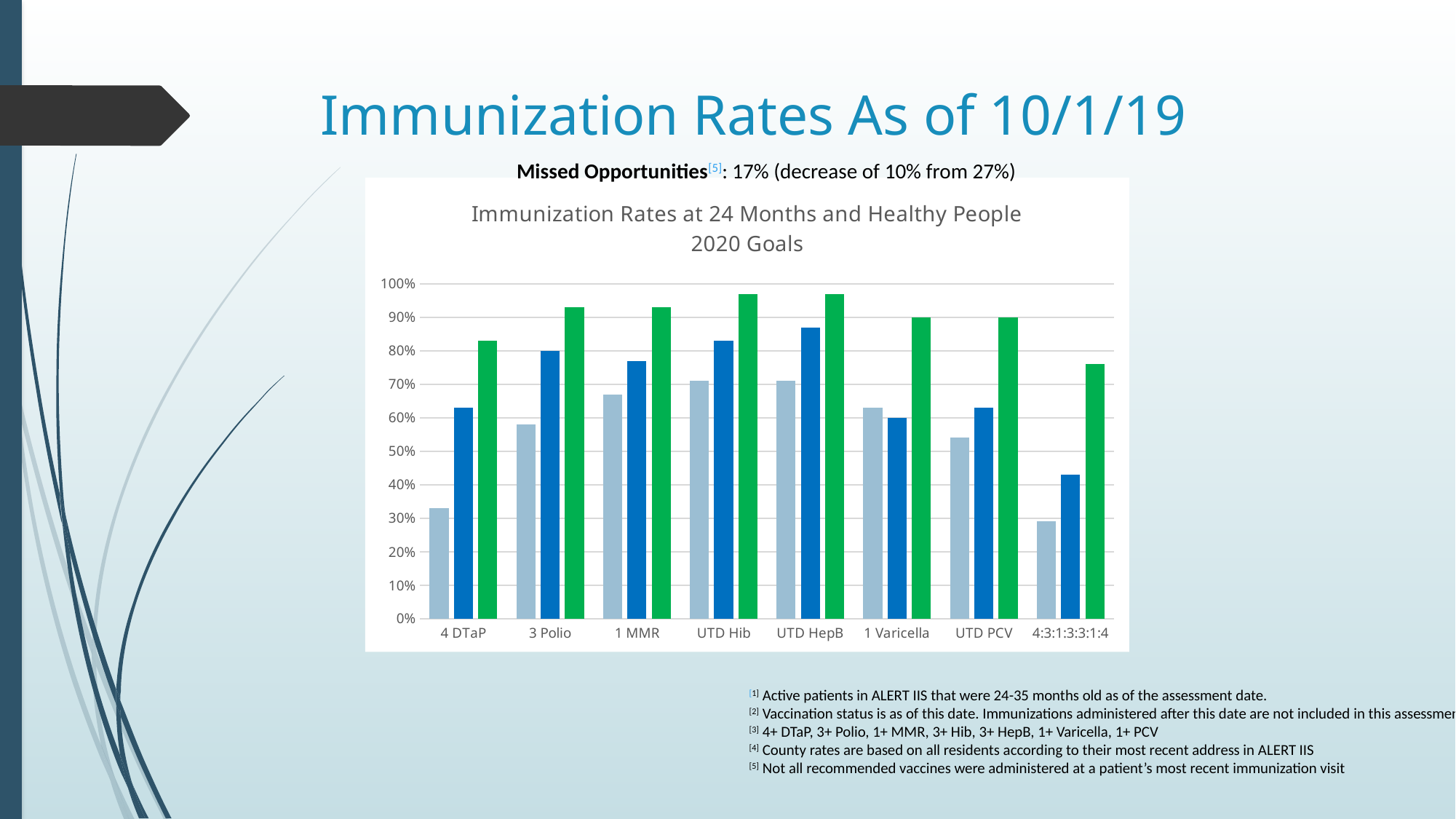
Is the value of the dark blue bar for 4:3:1:3:3:1:4 greater or less than 50%? less How many bars are plotted for each category in the chart? 3 Which category has the lowest green bar? 4:3:1:3:3:1:4 How many categories are shown along the x axis of the chart? 8 Which category has the lowest dark blue bar? 4:3:1:3:3:1:4 Is the value of the dark blue bar for UTD HepB greater or less than 80%? greater What is the title of the chart? Immunization Rates at 24 Months and Healthy People 2020 Goals What kind of chart is shown on the slide? bar chart Is the value of the green bar for 4:3:1:3:3:1:4 greater or less than 80%? less For 4 DTaP, which is larger: the dark blue bar or the green bar? the green bar